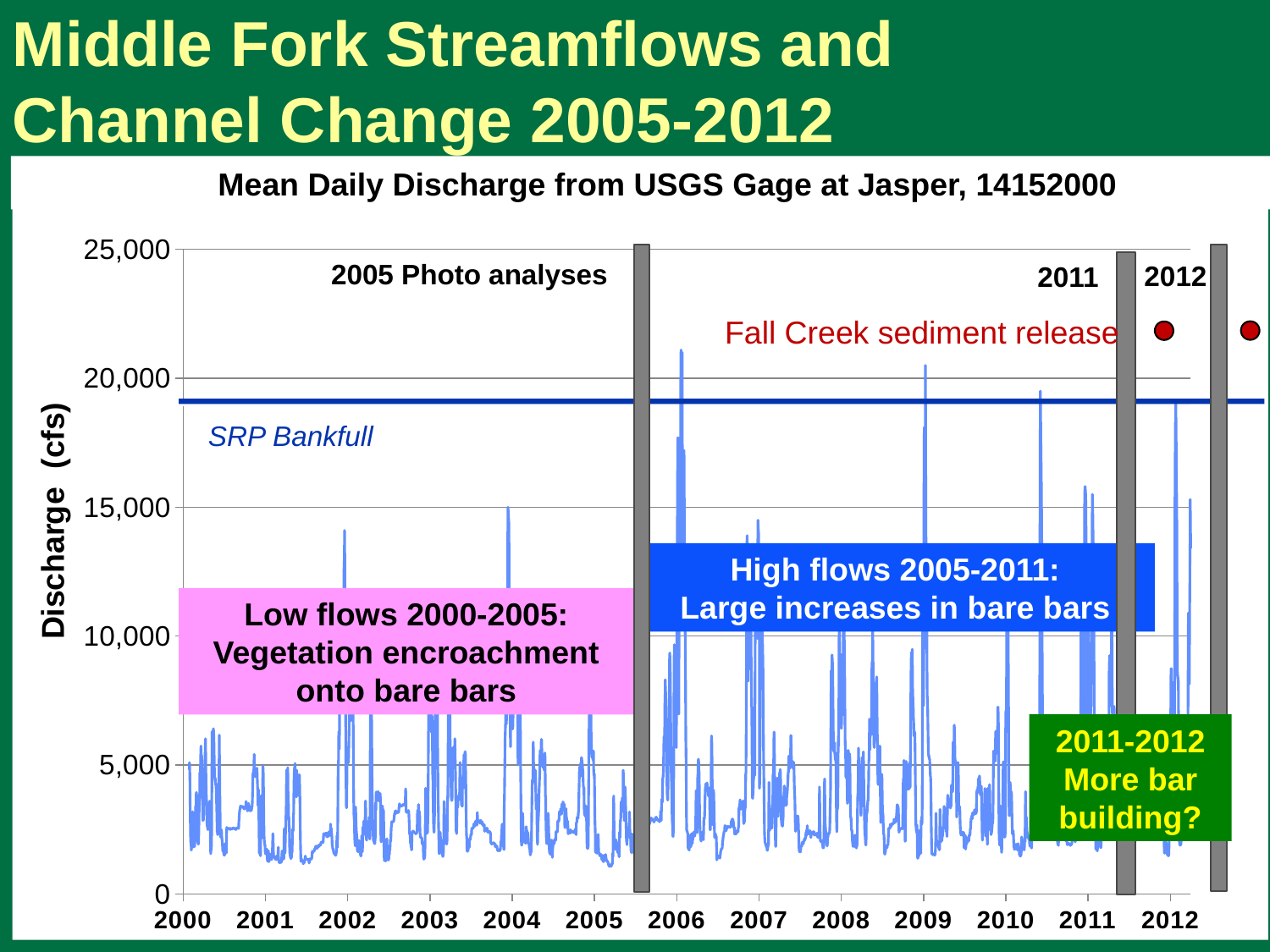
What kind of chart is shown on the slide? line chart Is the peak discharge in 2012 greater or less than 20,000? less What label is given to the horizontal blue reference line on the chart? SRP Bankfull Is the peak discharge in early 2006 greater or less than 20,000? greater Is the peak discharge in 2002 greater or less than 15,000? less How many year labels are shown along the x axis? 13 Which period shows higher peak flows, 2000-2005 or 2006-2011? 2006-2011 What is the highest value shown on the y axis? 25,000 What is the title of the chart? Mean Daily Discharge from USGS Gage at Jasper, 14152000